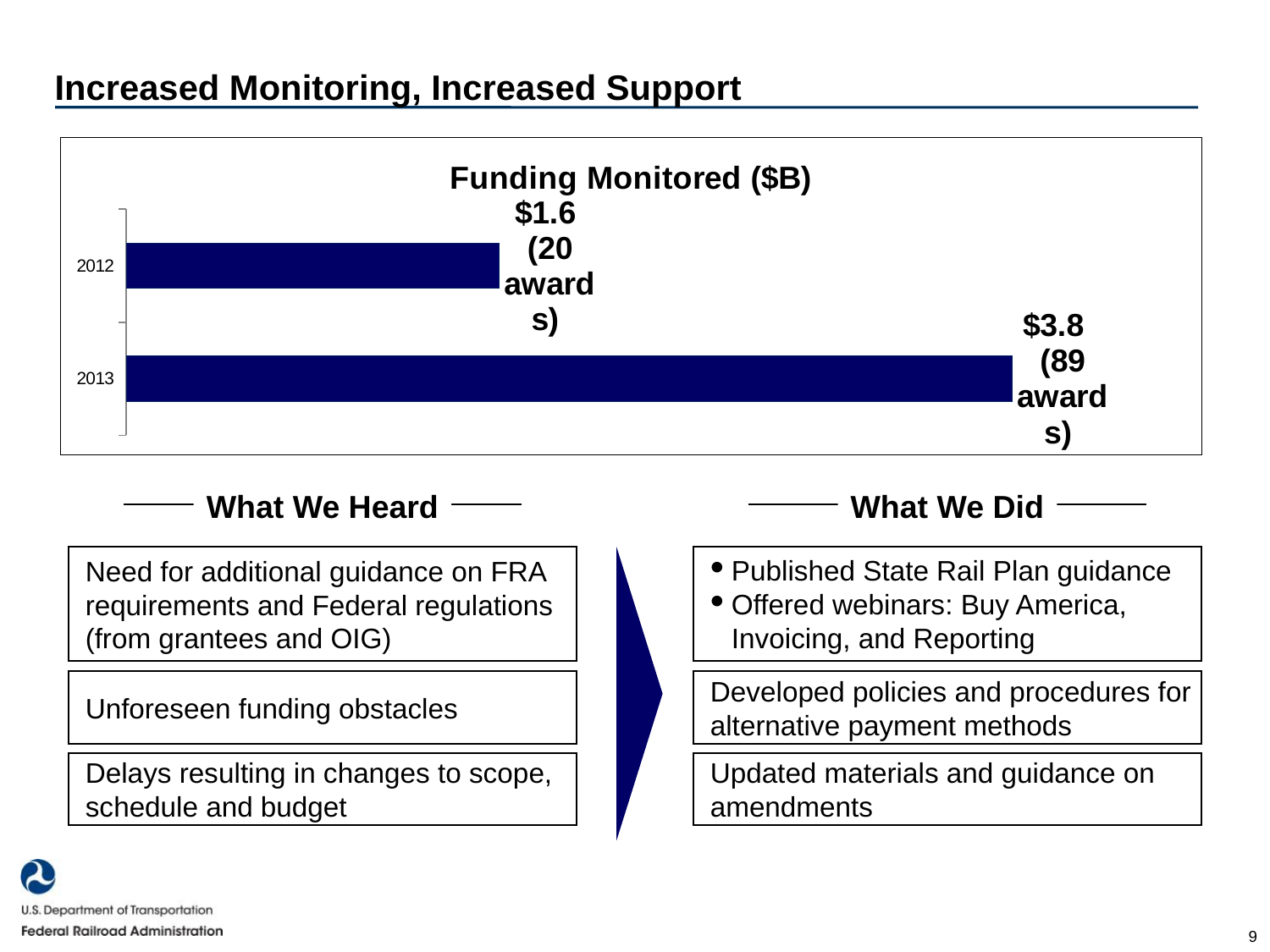
Is the funding monitored value for 2013 larger or smaller than the value for 2012? larger How many categories (years) are plotted in the chart? 2 What is the difference in funding monitored between 2013 and 2012? $2.2 What type of chart is shown on the slide? bar chart How many awards are noted for 2013 in the chart? 89 awards What is the funding monitored value for 2013? $3.8 Which year has the higher funding monitored value? 2013 How many awards are noted for 2012 in the chart? 20 awards What is the title of the chart? Funding Monitored ($B) What is the funding monitored value for 2012? $1.6 Which year has the lower funding monitored value? 2012 What colour are the bars in the chart? dark navy blue